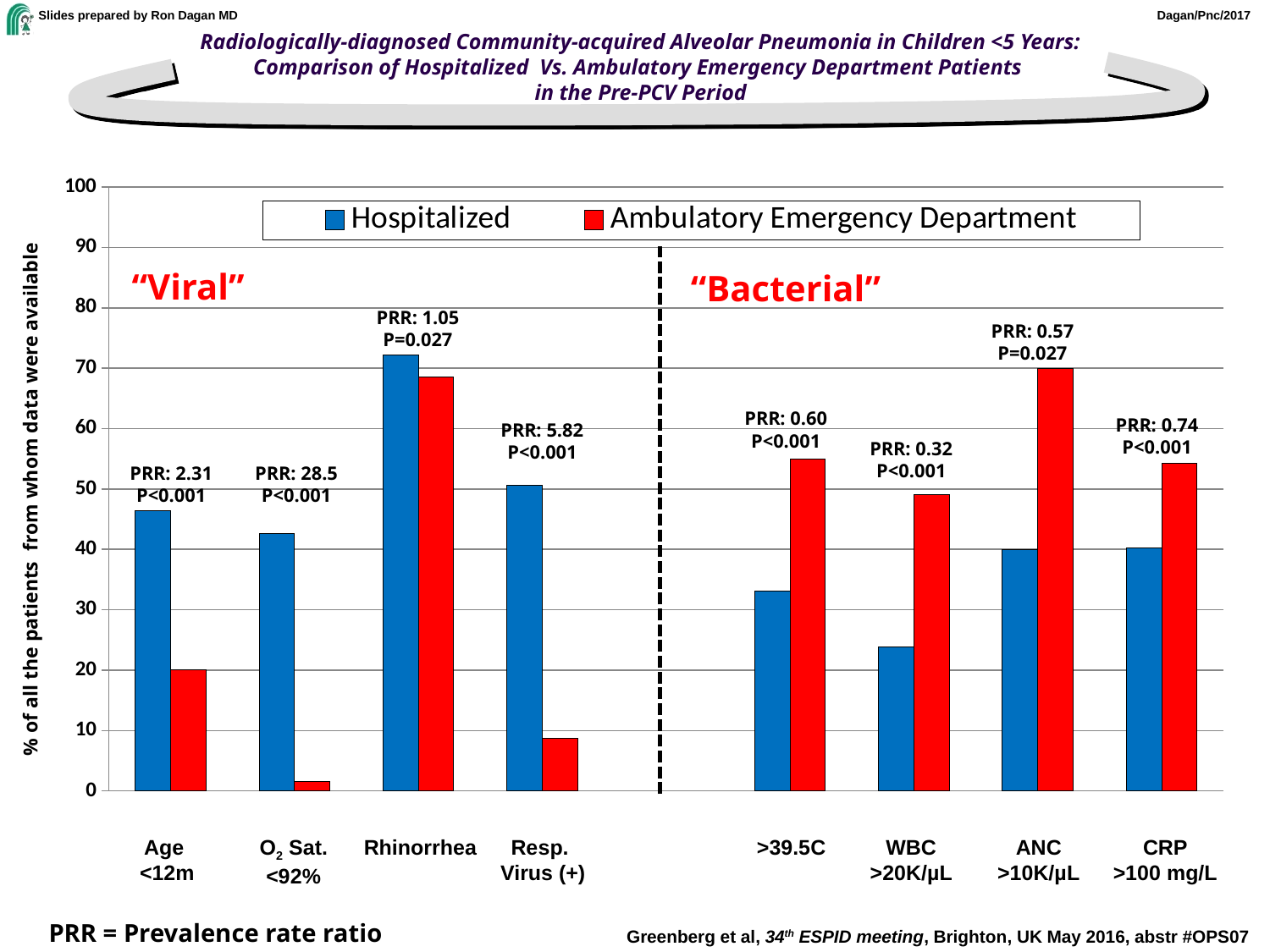
What PRR is printed above the bars for O2 Sat. <92%? PRR: 28.5 Which category has the highest Hospitalized bar? Rhinorrhea For Age <12m, which is larger: the Hospitalized bar or the Ambulatory Emergency Department bar? Hospitalized How many categories are plotted along the x axis? 8 What P value is printed for Rhinorrhea? P=0.027 How many series does the legend list? 2 Which category has the lowest Ambulatory Emergency Department bar? O2 Sat. <92% What kind of chart is shown on the slide? bar chart For ANC >10K/µL, which is larger: the Hospitalized bar or the Ambulatory Emergency Department bar? Ambulatory Emergency Department Is the Ambulatory Emergency Department value for Resp. Virus (+) greater or less than 10? less Which category has the highest Ambulatory Emergency Department bar? ANC >10K/µL Is the Hospitalized value for O2 Sat. <92% greater or less than 40? greater